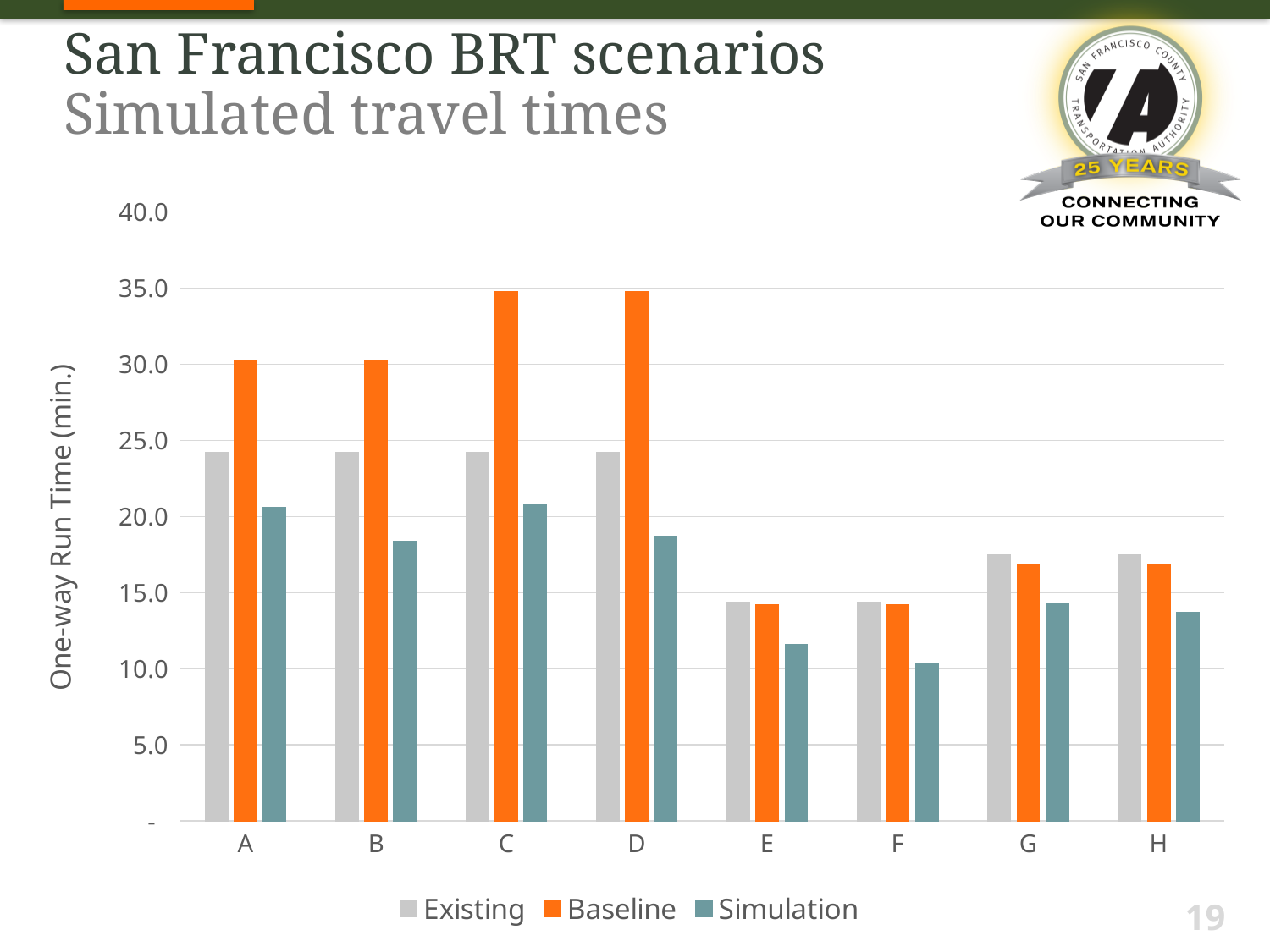
Is the Existing value for scenario G greater or less than 15.0? greater Is the Simulation value for scenario E greater or less than 15.0? less How many scenarios (categories) are shown on the x axis? 8 For scenario D, which is larger: the Existing value or the Simulation value? Existing What kind of chart is shown on the slide? bar chart For scenario A, which is larger: the Existing value or the Baseline value? Baseline Which series is shown in orange? Baseline Is the Baseline value for scenario C greater or less than 30.0? greater Which scenario has the lowest Simulation value? F What is the label on the y axis? One-way Run Time (min.) How many series does the legend list? 3